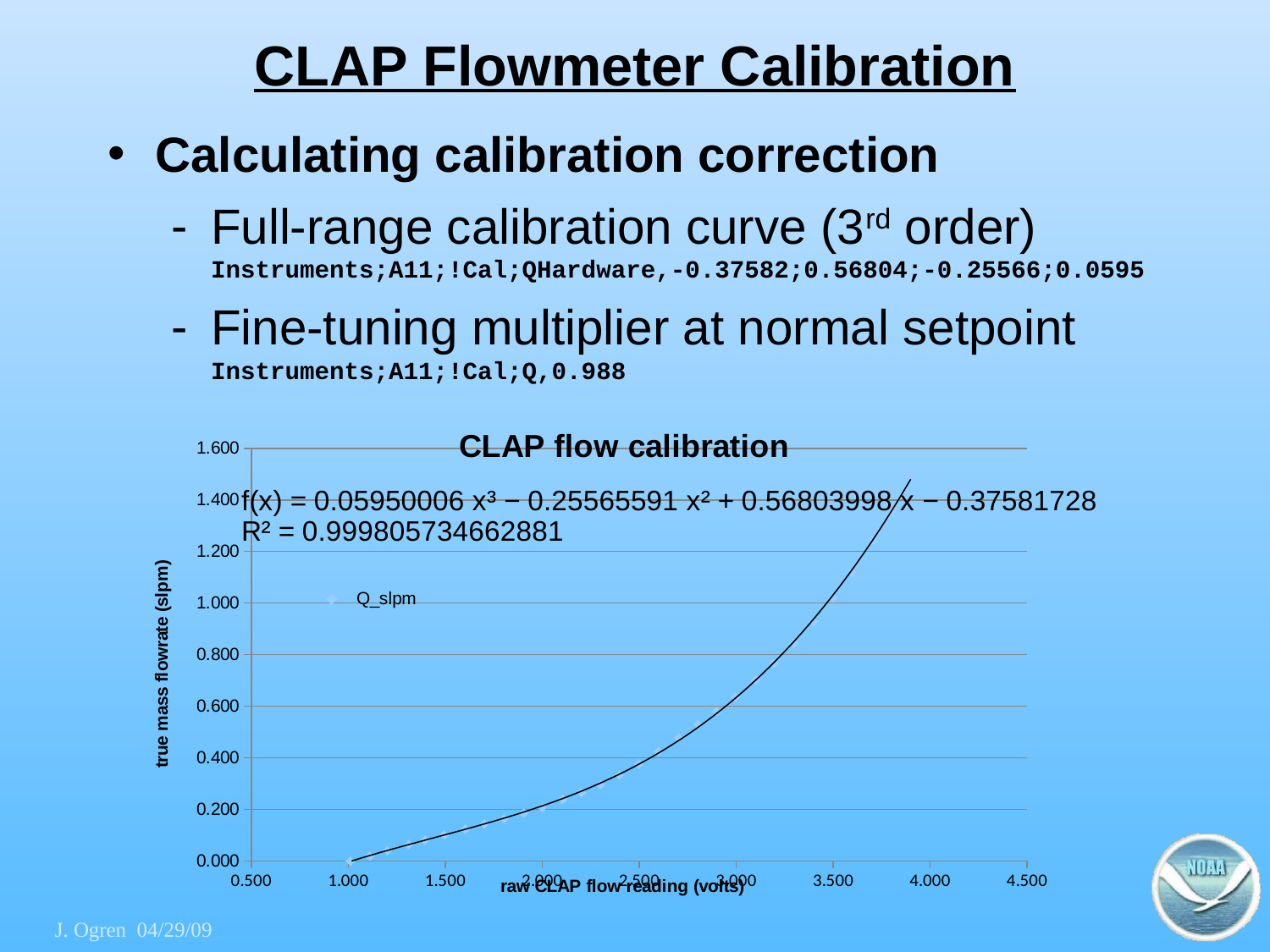
What is the constant term in the fitted equation shown on the chart? −0.37581728 What is the label of the y axis of the chart? true mass flowrate (slpm) Does the true mass flowrate rise or fall as the raw CLAP flow reading increases? rise What kind of chart is shown on the slide? scatter chart with a fitted curve Is the true mass flowrate at a raw reading of 2.500 volts greater or less than 0.200? greater What is the title of the chart? CLAP flow calibration How many series does the chart's legend list? 1 Is the true mass flowrate at a raw reading of 1.500 volts greater or less than 0.400? less What R² value is printed on the chart? 0.999805734662881 Is the true mass flowrate at a raw reading of 3.500 volts greater or less than 0.800? greater What is the coefficient of x³ in the fitted equation shown on the chart? 0.05950006 What is the highest tick value shown on the y axis of the chart? 1.600